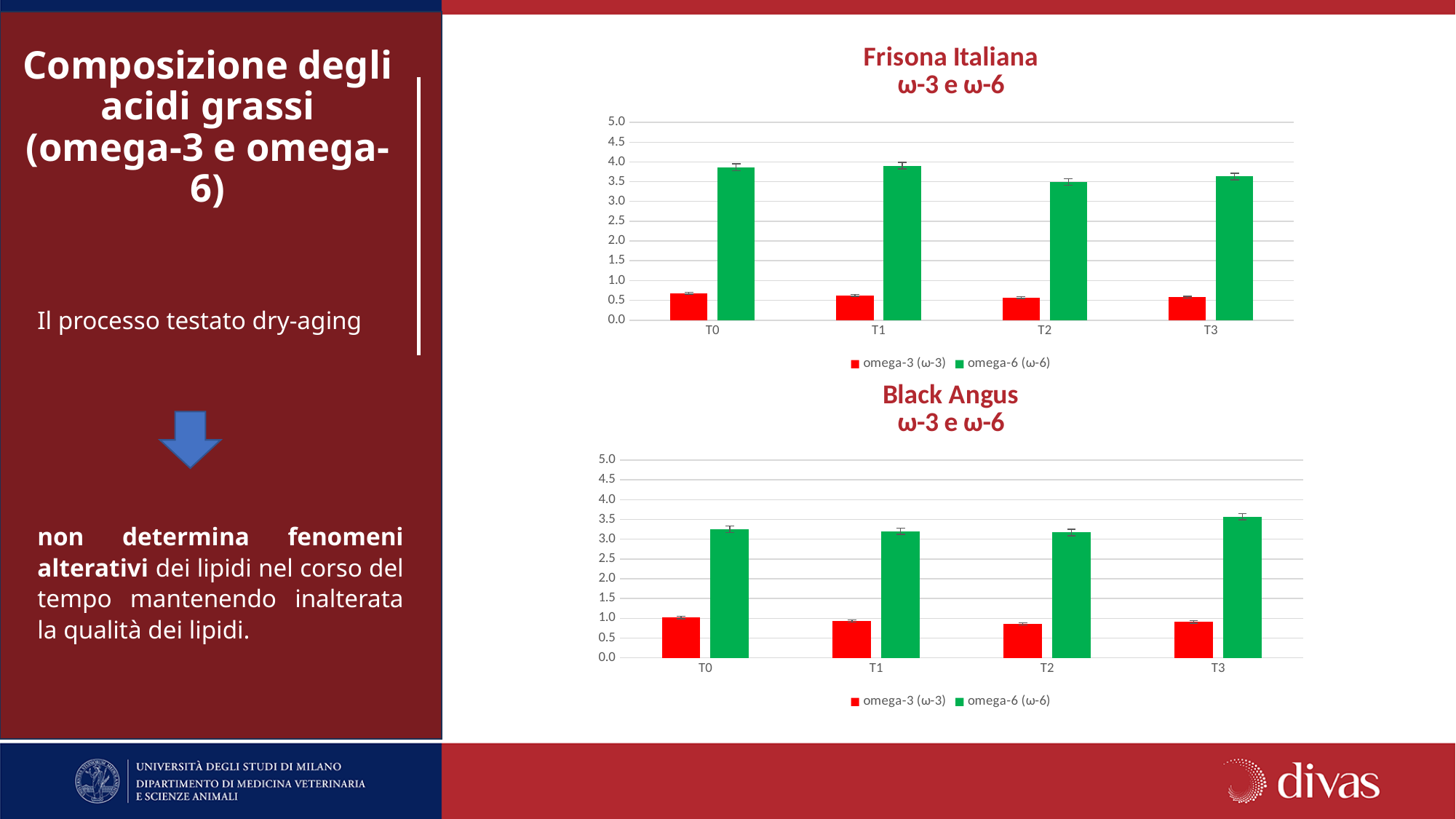
In the Black Angus chart, how many time points are shown on the x axis? 4 In the Frisona Italiana chart, is the omega-6 (ω-6) value at T0 greater or less than 3.5? greater In the Frisona Italiana chart, what kind of chart is shown? bar chart In the Black Angus chart, at which time point is the omega-3 (ω-3) value highest? T0 In the Frisona Italiana chart, at which time point is the omega-6 (ω-6) value lowest? T2 In the Frisona Italiana chart, how many series does the legend list? 2 In the Frisona Italiana chart, which is larger at T1: omega-3 (ω-3) or omega-6 (ω-6)? omega-6 (ω-6) In the Black Angus chart, is the omega-3 (ω-3) value at T0 greater or less than 1.5? less In the Black Angus chart, what colour are the omega-3 (ω-3) bars? red In the Black Angus chart, at which time point is the omega-6 (ω-6) value highest? T3 In the Frisona Italiana chart, is the omega-3 (ω-3) value at T2 greater or less than 1.0? less